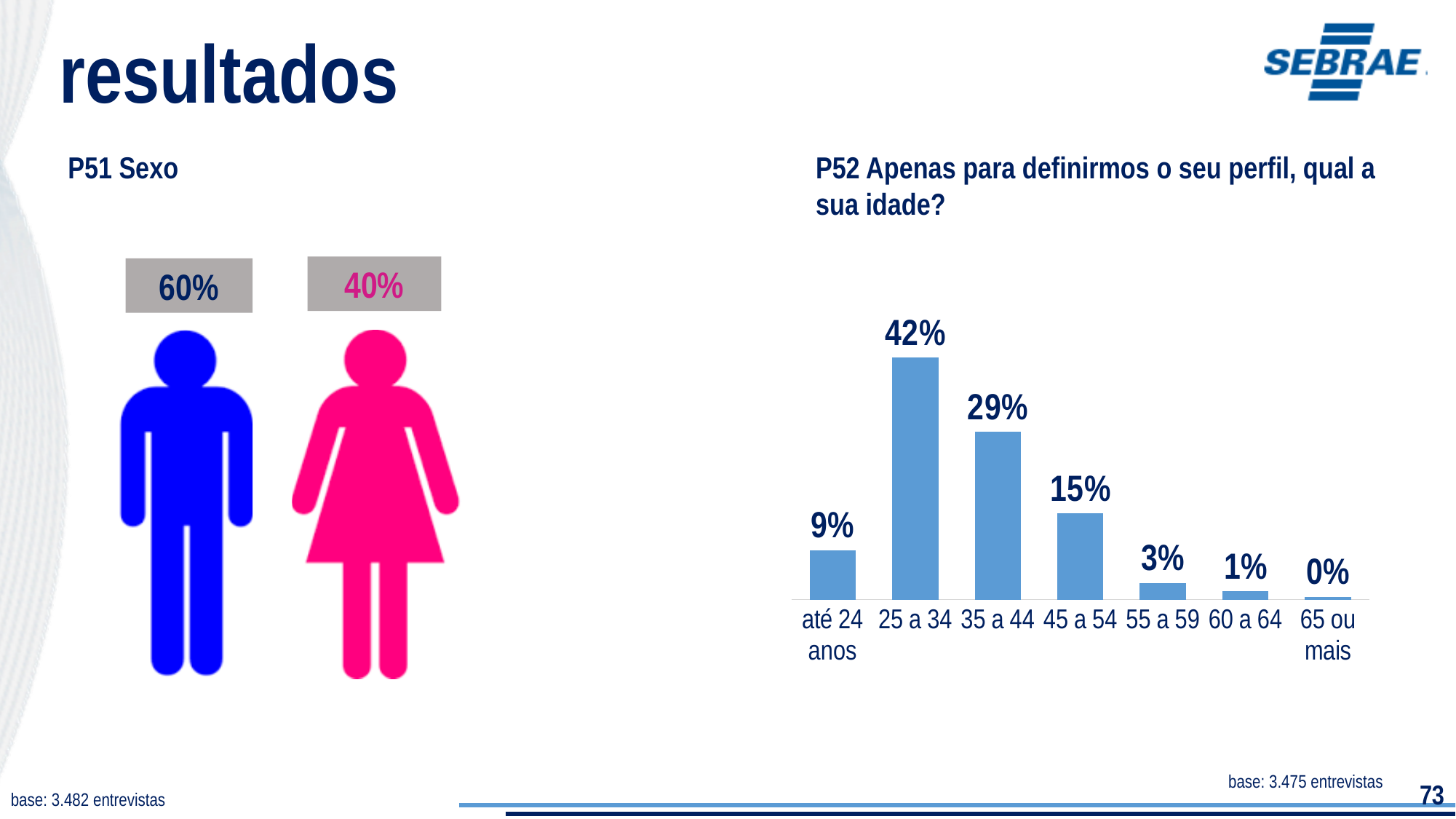
In the P52 age chart, which is larger: the value for '35 a 44' or for '45 a 54'? 35 a 44 In the P52 age chart, what is the value for the '45 a 54' category? 15% In the P51 Sexo graphic, what percentage is shown for the male figure? 60% How many age categories are shown in the P52 chart? 7 In the P52 age chart, what is the difference between the '25 a 34' and '35 a 44' values? 13% In the P51 Sexo graphic, what percentage is shown for the female figure? 40% In the P52 age chart, do the values rise or fall from '25 a 34' to '65 ou mais'? fall What kind of chart is used for P52 (age)? bar chart In the P52 age chart, which age category has the lowest value? 65 ou mais In the P52 age chart, which age category has the highest value? 25 a 34 In the P52 age chart, what is the value for the '25 a 34' category? 42% In the P52 age chart, what is the value for 'até 24 anos'? 9%